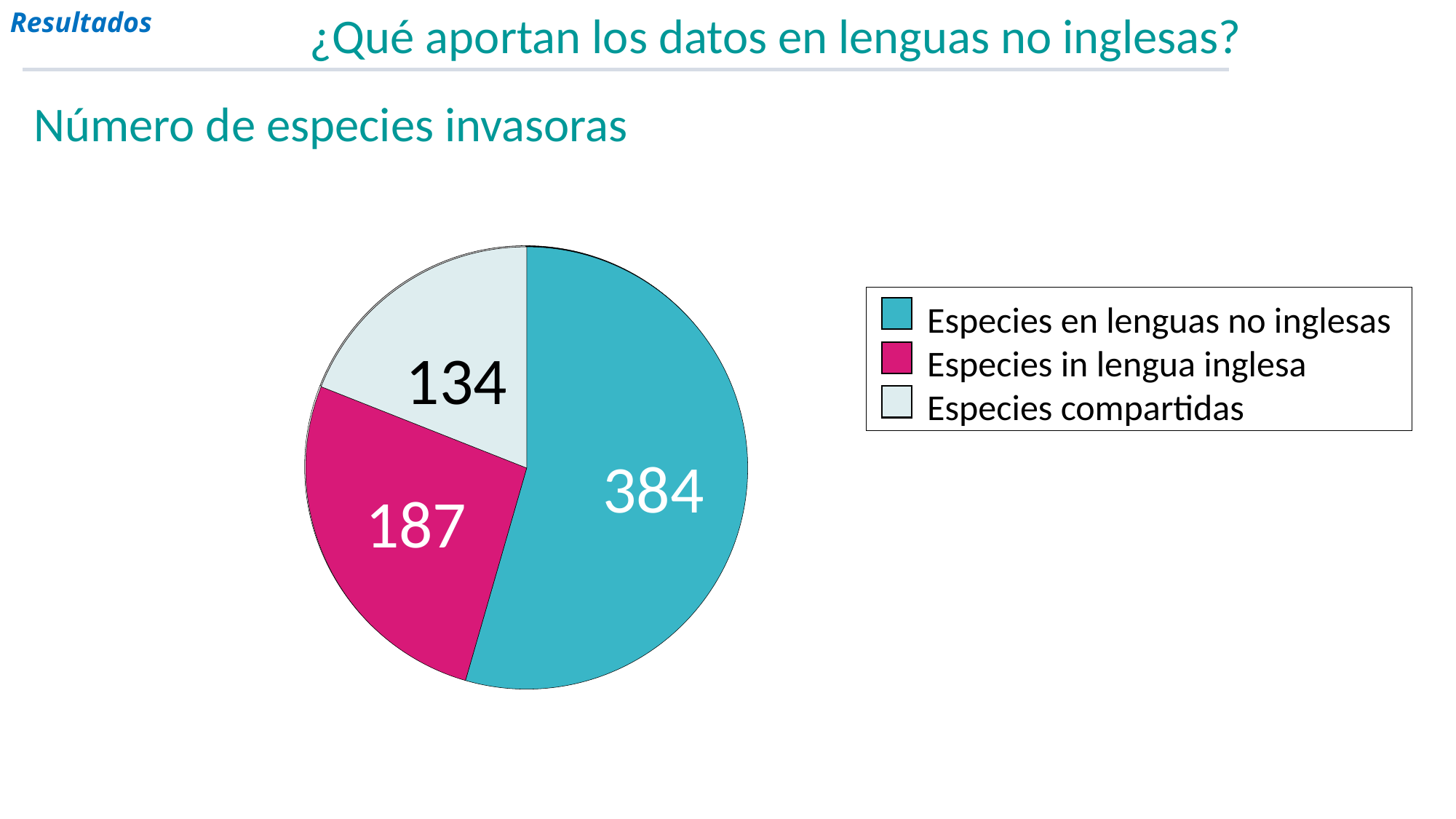
What type of chart is shown on the slide? Pie chart What is the total number of species across all three slices? 705 What is the difference between the 'Especies en lenguas no inglesas' and 'Especies in lengua inglesa' values? 197 Which is larger: 'Especies in lengua inglesa' or 'Especies compartidas'? Especies in lengua inglesa What is the title of the chart? Número de especies invasoras Which category has the smallest slice of the pie? Especies compartidas What is the value of the 'Especies in lengua inglesa' slice? 187 How many slices does the pie chart have? 3 What is the value shown for 'Especies compartidas'? 134 Which category has the largest slice of the pie? Especies en lenguas no inglesas How many species are in the 'Especies en lenguas no inglesas' slice? 384 What is the difference between the 'Especies in lengua inglesa' and 'Especies compartidas' values? 53